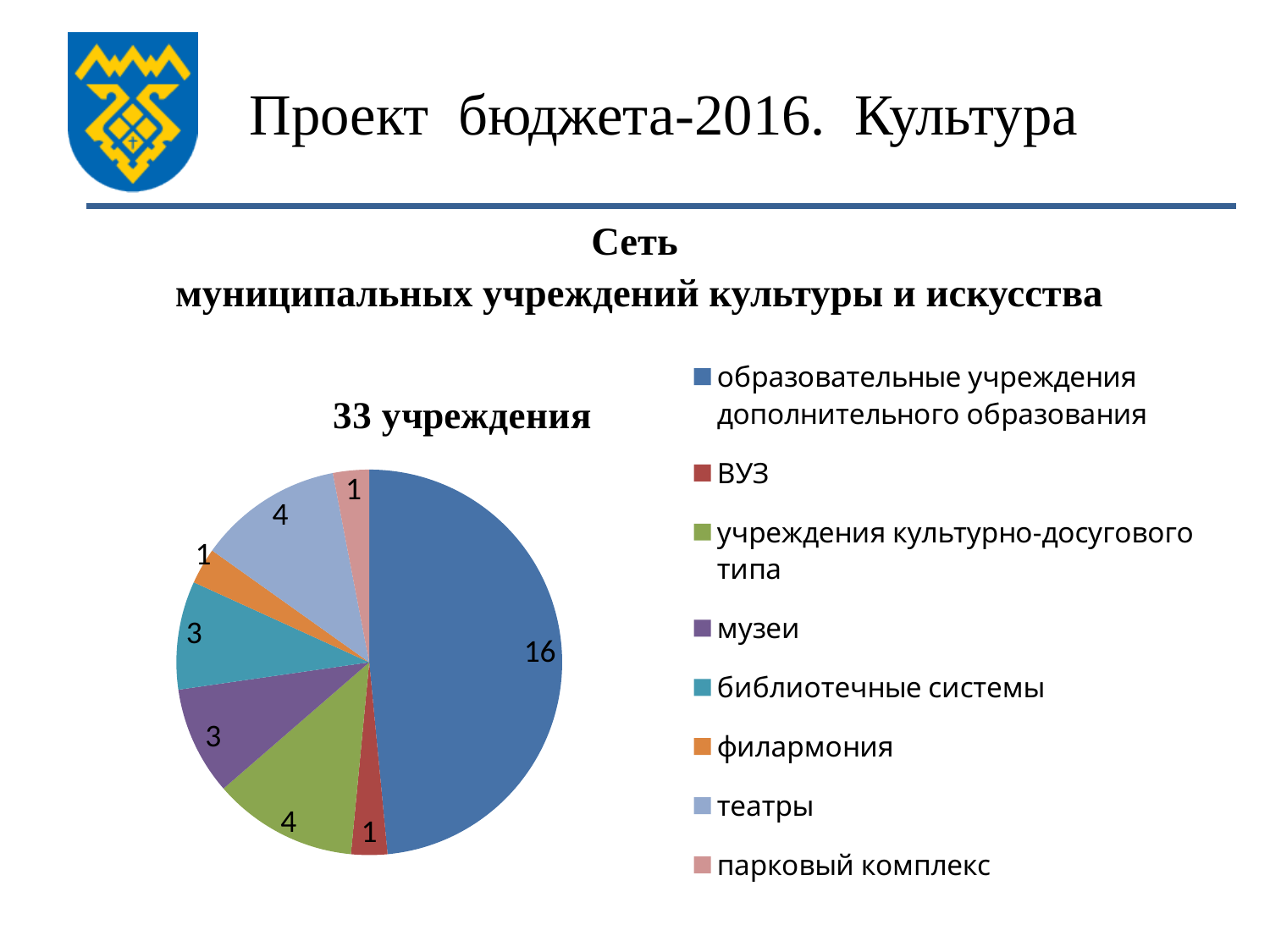
What is the value for образовательные учреждения дополнительного образования? 16 Which category has the largest slice of the pie? образовательные учреждения дополнительного образования What is the title of the pie chart? 33 учреждения What is the total of all slices in the pie chart? 33 What is the value for театры? 4 Which is larger, the value for музеи or the value for филармония? музеи What type of chart is shown on the slide? pie chart What is the difference between the value for образовательные учреждения дополнительного образования and the value for театры? 12 What colour is the slice for ВУЗ? dark red How many categories does the legend of the pie chart list? 8 What is the value for учреждения культурно-досугового типа? 4 What is the value for библиотечные системы? 3